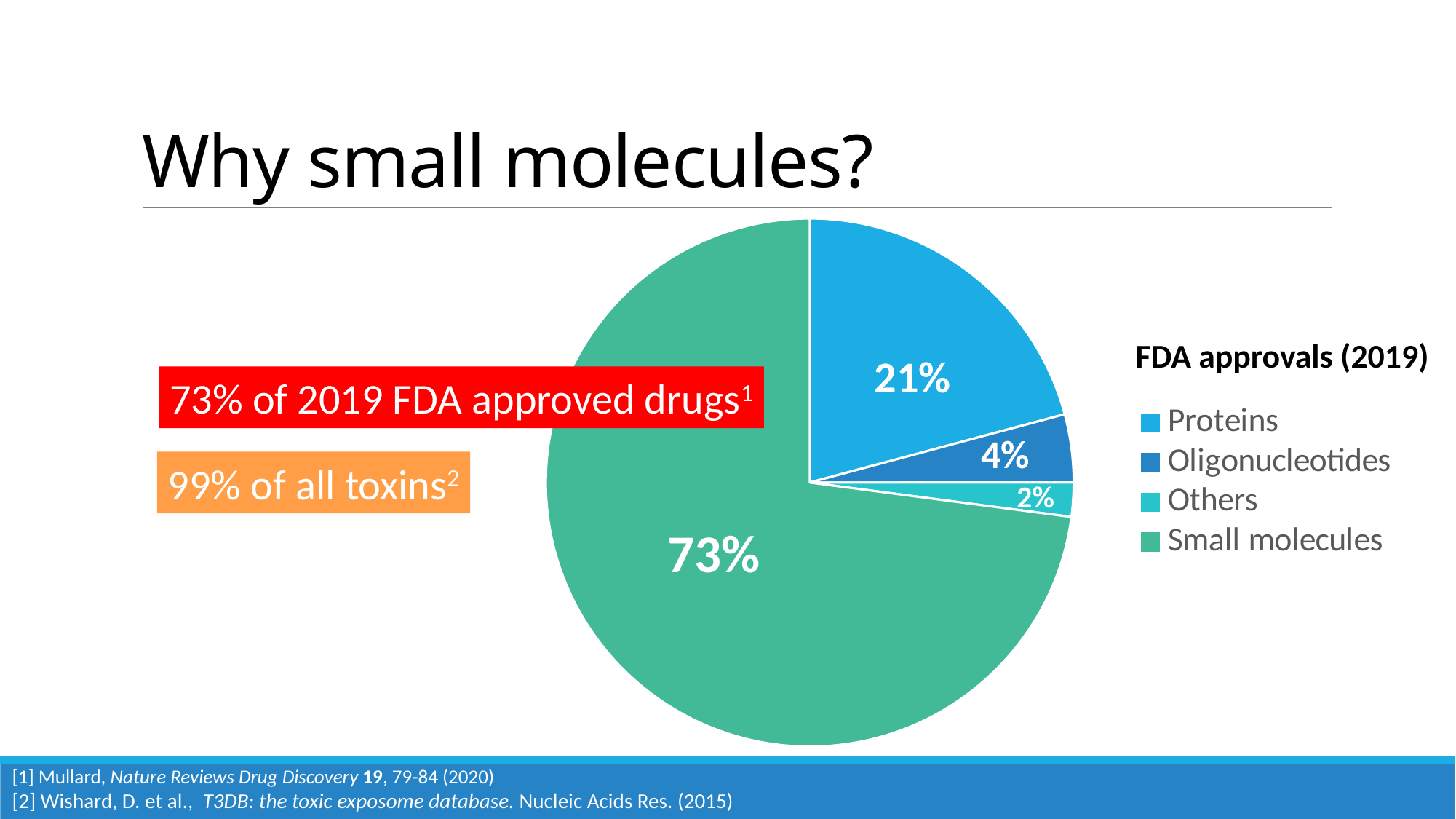
What share of FDA approvals (2019) is Proteins? 21% What colour is the Small molecules slice? green What is the title of the pie chart's legend? FDA approvals (2019) Which category has the smallest slice of the pie? Others How many categories does the pie chart show? 4 What share of FDA approvals (2019) is Oligonucleotides? 4% Which is larger, the share for Proteins or the share for Oligonucleotides? Proteins What share of FDA approvals (2019) is Others? 2% What is the difference in percentage points between Small molecules and Proteins? 52 Which category has the largest slice of the pie? Small molecules What type of chart is shown on the slide? pie chart